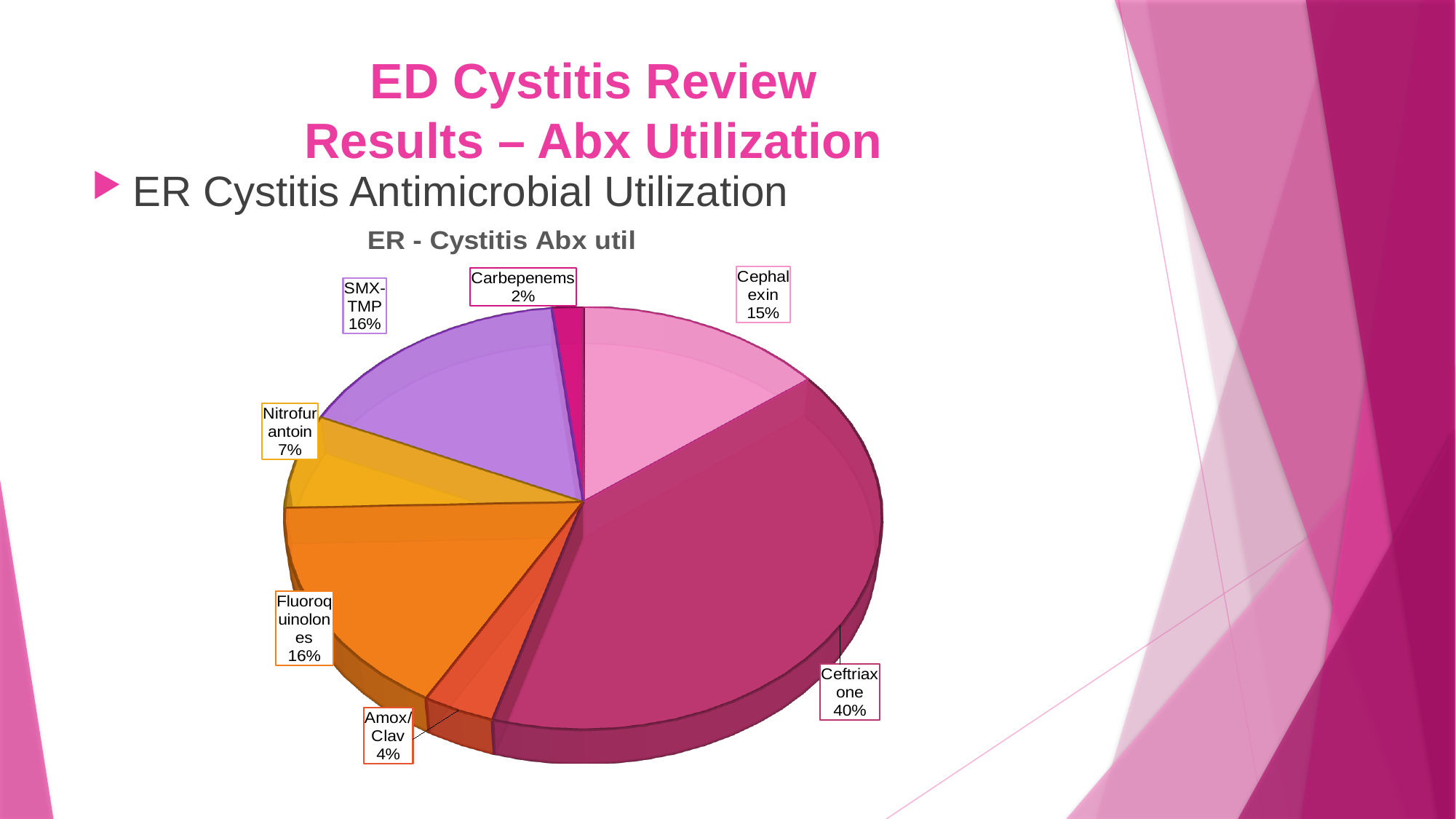
Which antibiotic has the smallest slice of the pie? Carbepenems What percentage is shown for Amox/Clav? 4% Which antibiotic has the largest slice of the pie? Ceftriaxone What is the title of the chart? ER - Cystitis Abx util What is the difference in percentage points between Ceftriaxone and Cephalexin? 25 What percentage is shown for Nitrofurantoin? 7% How many slices does the pie chart have? 7 What percentage is shown for Cephalexin? 15% What is the combined percentage of SMX-TMP and Fluoroquinolones? 32% What type of chart is shown on the slide? Pie chart What share of the pie does Ceftriaxone represent? 40% Which is larger, the share for Nitrofurantoin or the share for Amox/Clav? Nitrofurantoin